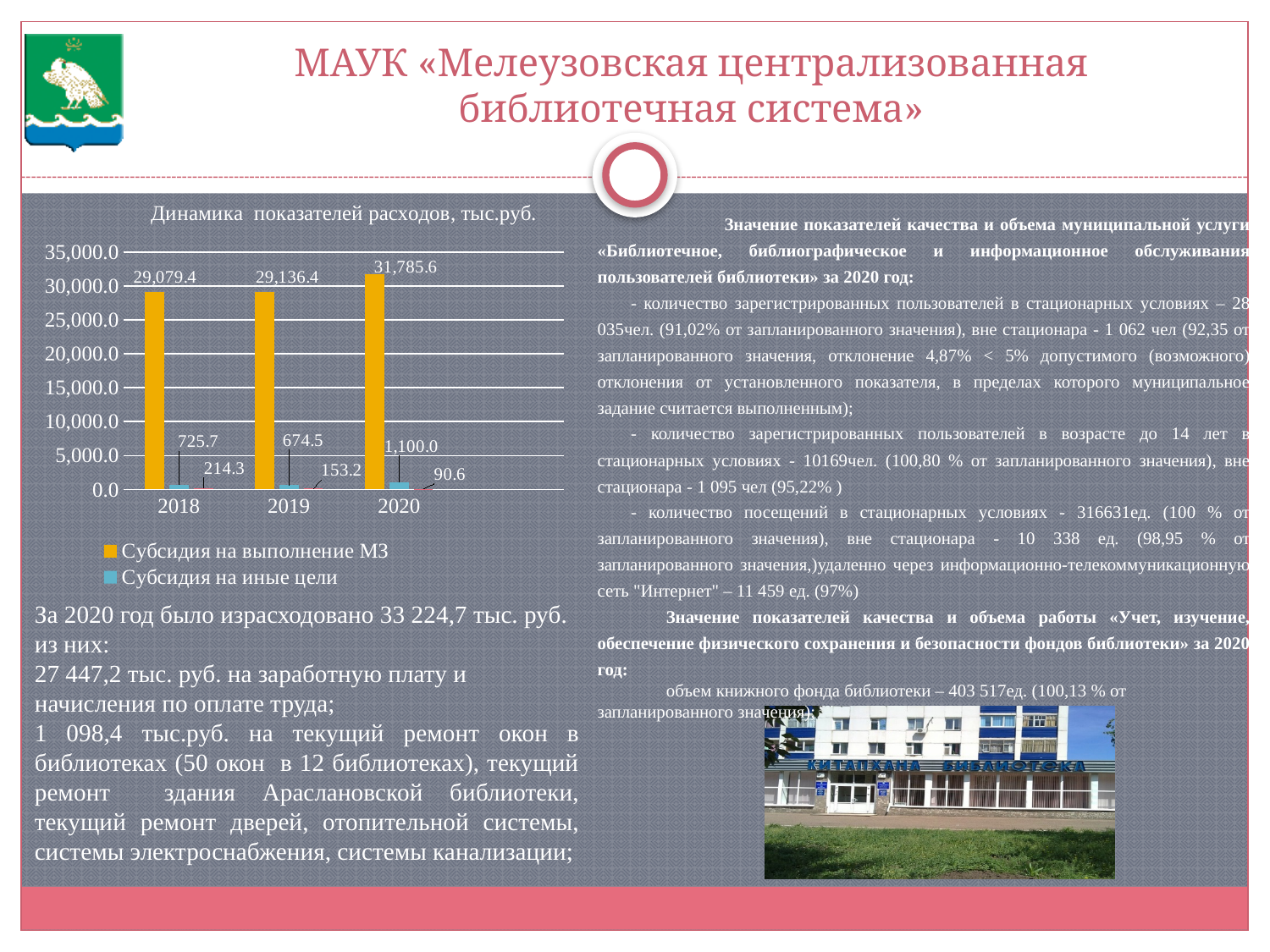
What type of chart is shown under the title "Динамика показателей расходов, тыс.руб."? bar chart In which year is "Субсидия на выполнение МЗ" the lowest? 2018 What is the value of "Субсидия на выполнение МЗ" for 2019? 29,136.4 Does "Субсидия на выполнение МЗ" rise or fall from 2018 to 2020? rise What is the difference between the "Субсидия на выполнение МЗ" values for 2020 and 2018? 2,706.2 What is the value of "Субсидия на выполнение МЗ" for 2020? 31,785.6 What is the difference between the "Субсидия на выполнение МЗ" values for 2020 and 2019? 2,649.2 How many years are shown on the x axis of the chart? 3 In which year is "Субсидия на выполнение МЗ" the highest? 2020 Which colour represents "Субсидия на выполнение МЗ" in the chart legend? yellow What is the value of "Субсидия на выполнение МЗ" for 2018? 29,079.4 Is the value of "Субсидия на выполнение МЗ" for 2020 greater or less than 30,000.0? greater